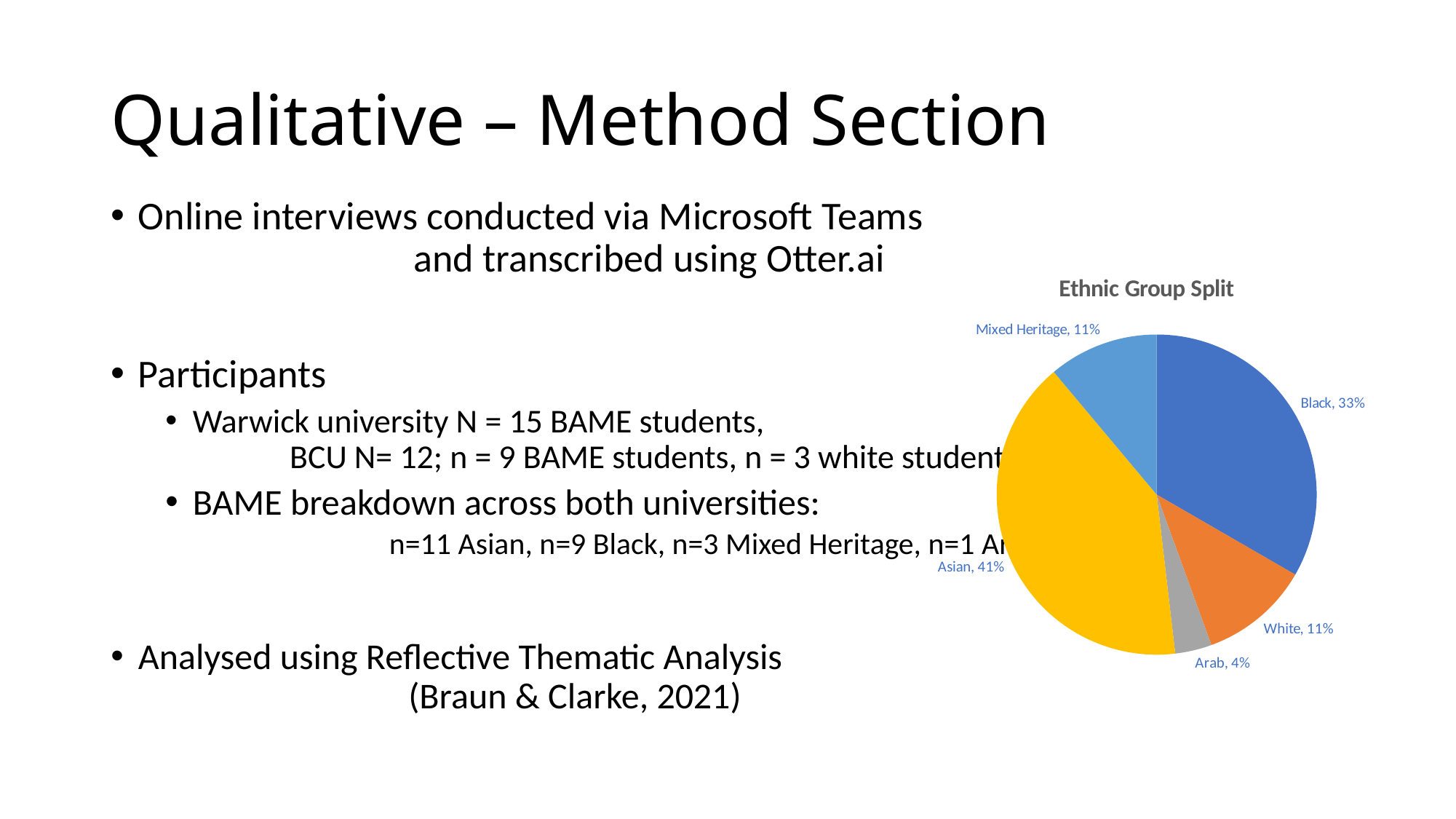
What share of the pie does White represent? 11% What share of the pie does Asian represent? 41% What colour is the Asian slice of the pie? yellow What share of the pie does Black represent? 33% How many slices does the pie chart have? 5 Which slice is larger, Black or White? Black What share of the pie does Arab represent? 4% Which ethnic group has the smallest slice of the pie? Arab Which ethnic group has the largest slice of the pie? Asian What kind of chart is shown on the slide? pie chart What is the difference in percentage points between the Asian and Black slices? 8 What is the title of the chart? Ethnic Group Split